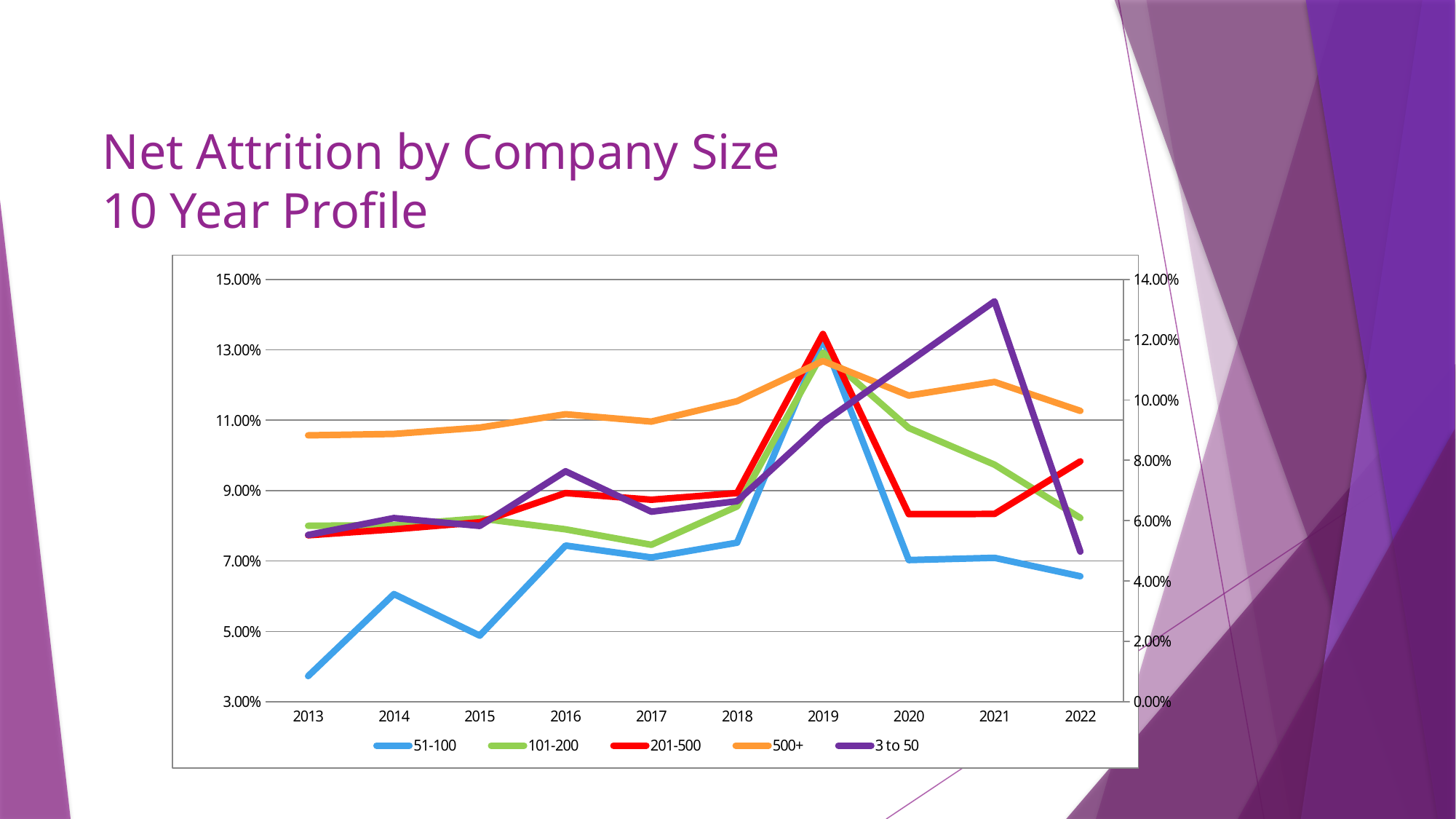
Which colour is used for the 201-500 series? red In which year does the 3 to 50 series reach its highest value? 2021 In which year does the 201-500 series reach its highest value? 2019 How many series does the legend list? 5 In which year does the 51-100 series have its lowest value? 2013 In which year does the 51-100 series reach its highest value? 2019 Does the 3 to 50 series rise or fall from 2017 to 2021? rise How many years are plotted along the x axis? 10 Does the 51-100 series rise or fall from 2019 to 2022? fall What kind of chart is shown on the slide? line chart For the 51-100 series, is the value higher in 2019 or in 2020? 2019 What is the title of the slide's chart? Net Attrition by Company Size 10 Year Profile